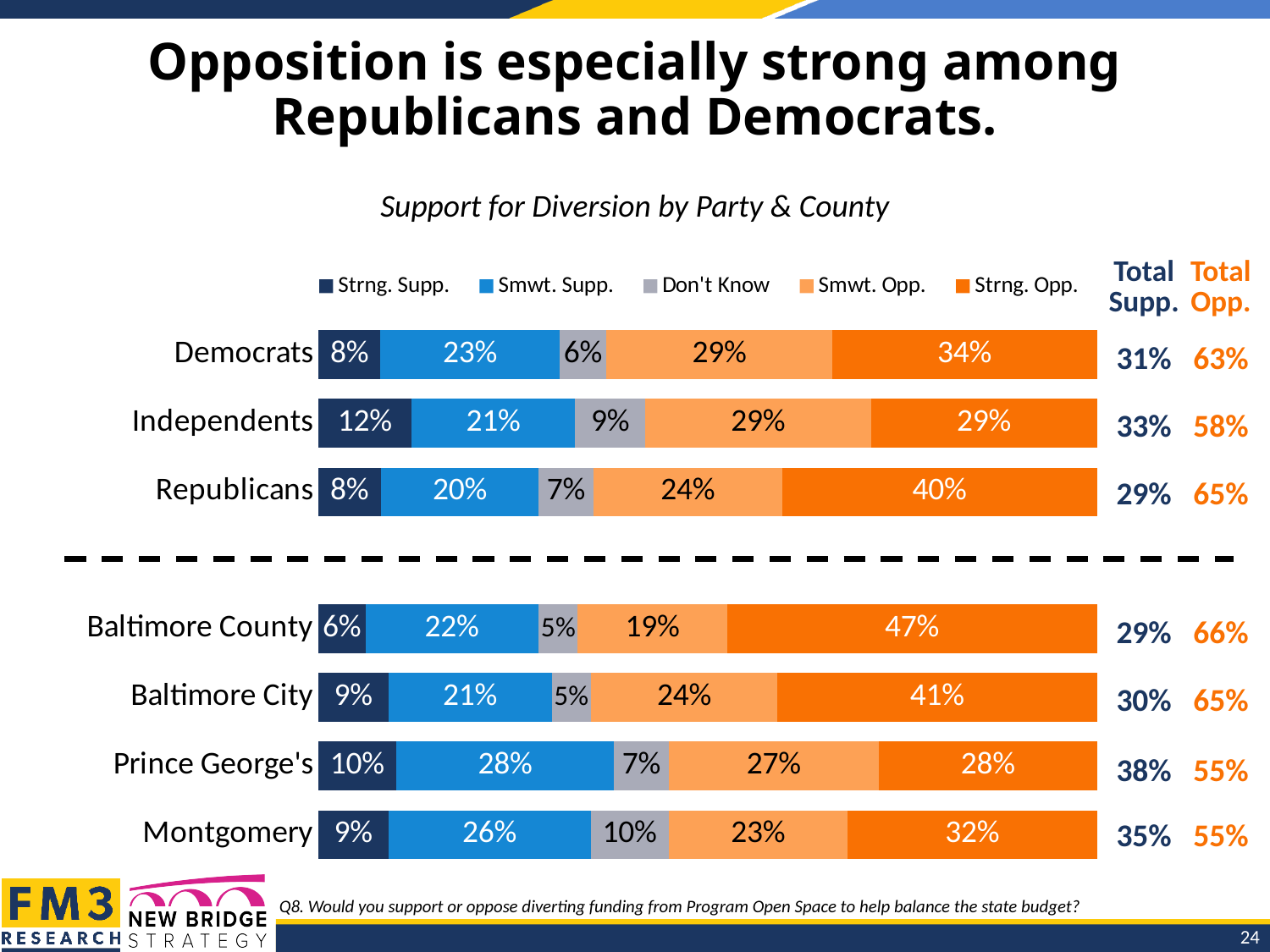
How many series does the legend list? 5 Which category has the highest Strng. Opp. value? Baltimore County What kind of chart is shown on the slide? Stacked bar chart What is the Total Opp. shown for Independents? 58% What is the Strng. Opp. value for Republicans? 40% Which category has the lowest Strng. Supp. value? Baltimore County How many categories (bars) are plotted in the chart? 7 What is the chart's title? Support for Diversion by Party & County What is the Don't Know value for Montgomery? 10% What is the Smwt. Supp. value for Prince George's? 28% Which has a larger Smwt. Opp. value, Independents or Republicans? Independents What is the difference between the Strng. Opp. values for Baltimore County and Democrats? 13%